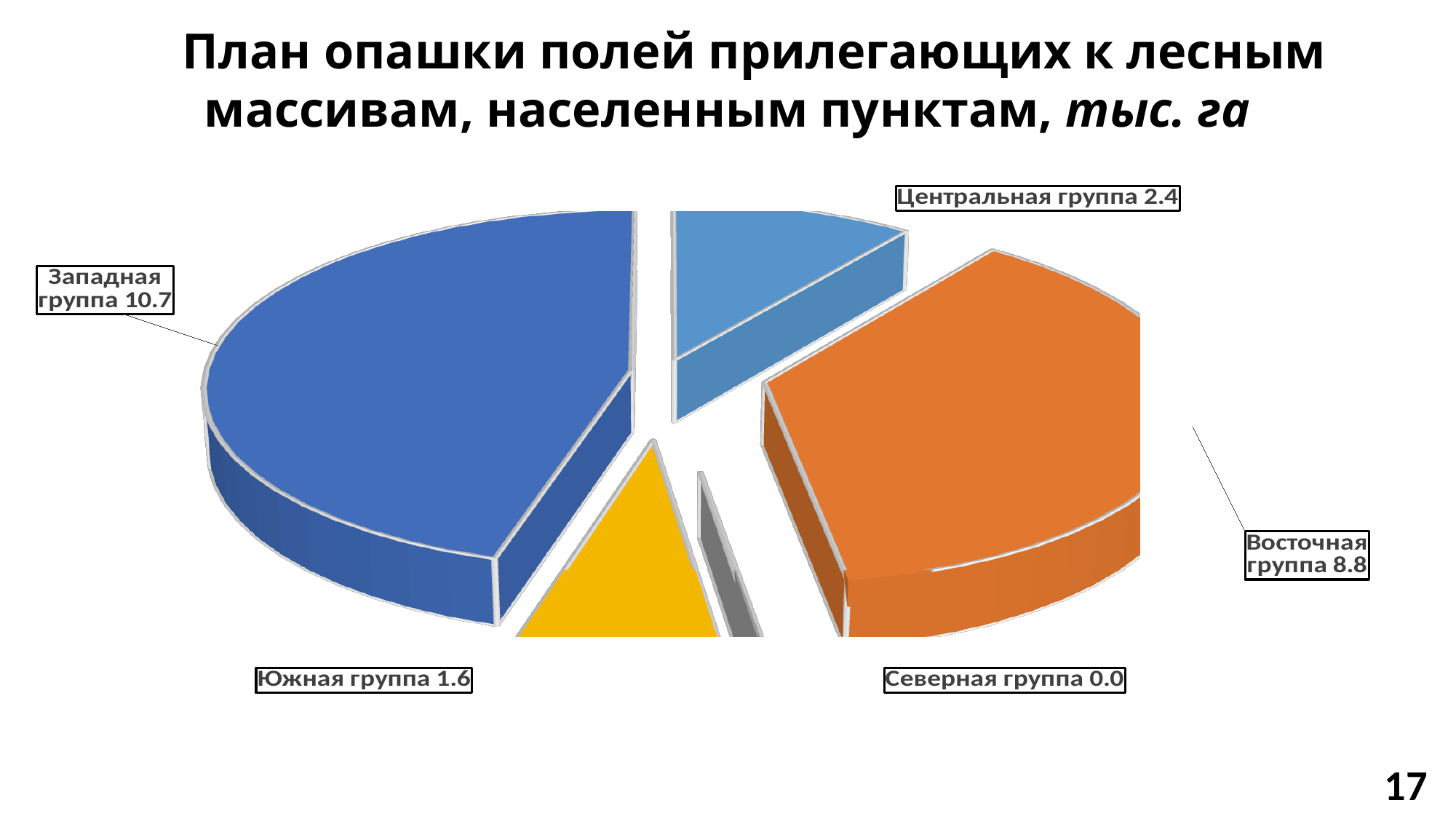
How many groups (slices) are shown in the pie chart? 5 What is the value for Западная группа? 10.7 What unit of measurement is given in the chart title? тыс. га Which group has the largest slice of the pie? Западная группа Which is larger, the value for Центральная группа or Южная группа? Центральная группа What is the value for Южная группа? 1.6 What is the value for Центральная группа? 2.4 What is the difference between the values for Западная группа and Восточная группа? 1.9 What kind of chart is shown on the slide? pie chart What is the value for Восточная группа? 8.8 Which group has the smallest value? Северная группа What is the value for Северная группа? 0.0